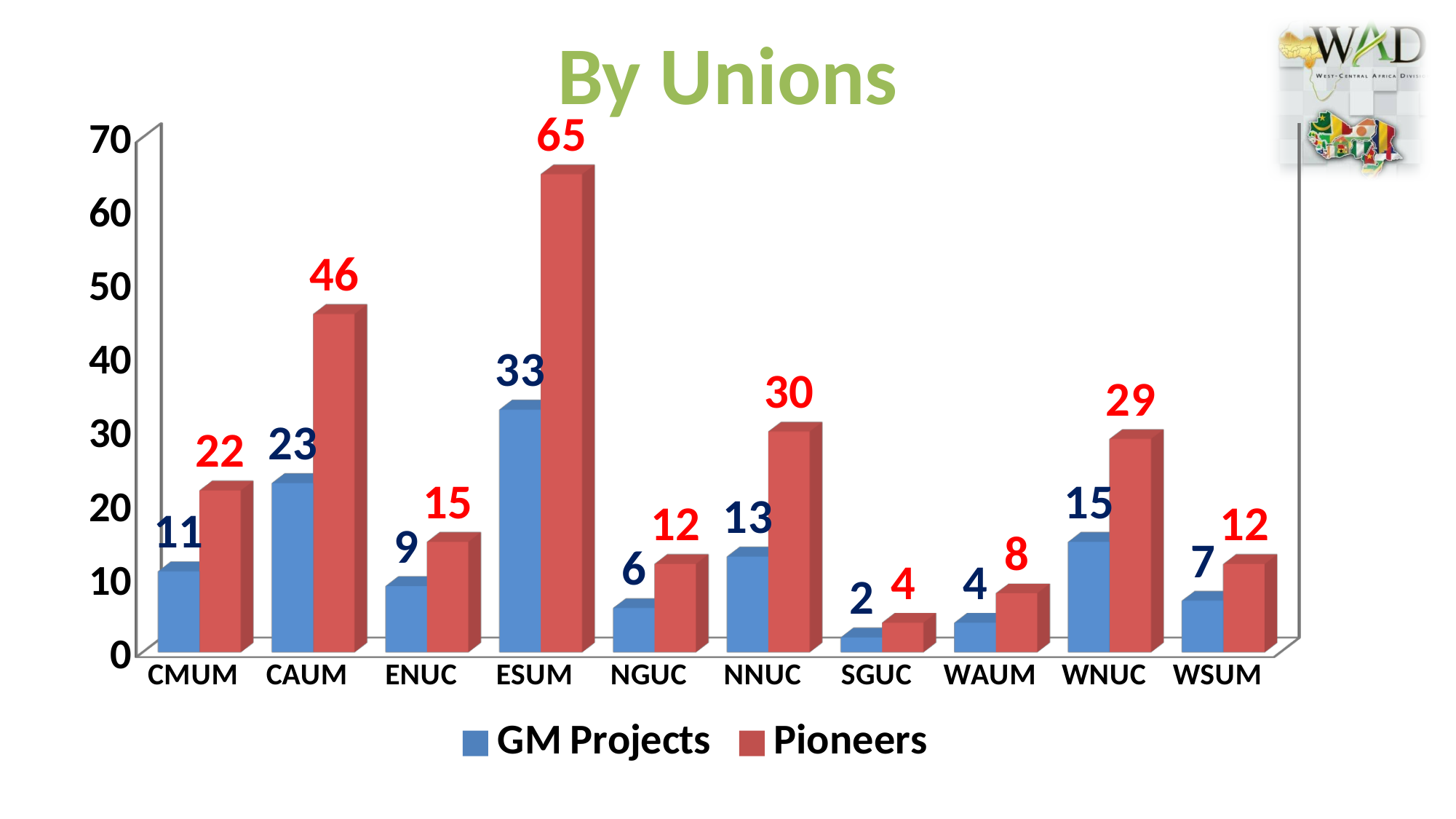
How many unions are shown on the x axis? 10 How many series does the legend list? 2 What is the value of GM Projects for CAUM? 23 Which union has the highest Pioneers value? ESUM Is the Pioneers value for WNUC greater or less than 20? greater What is the title of the chart? By Unions Which union has the lowest GM Projects value? SGUC What is the value of Pioneers for ESUM? 65 Which is larger, the Pioneers value for CAUM or the Pioneers value for NNUC? CAUM What is the difference between Pioneers and GM Projects for NNUC? 17 What is the value of GM Projects for WNUC? 15 What kind of chart is shown on the slide? bar chart